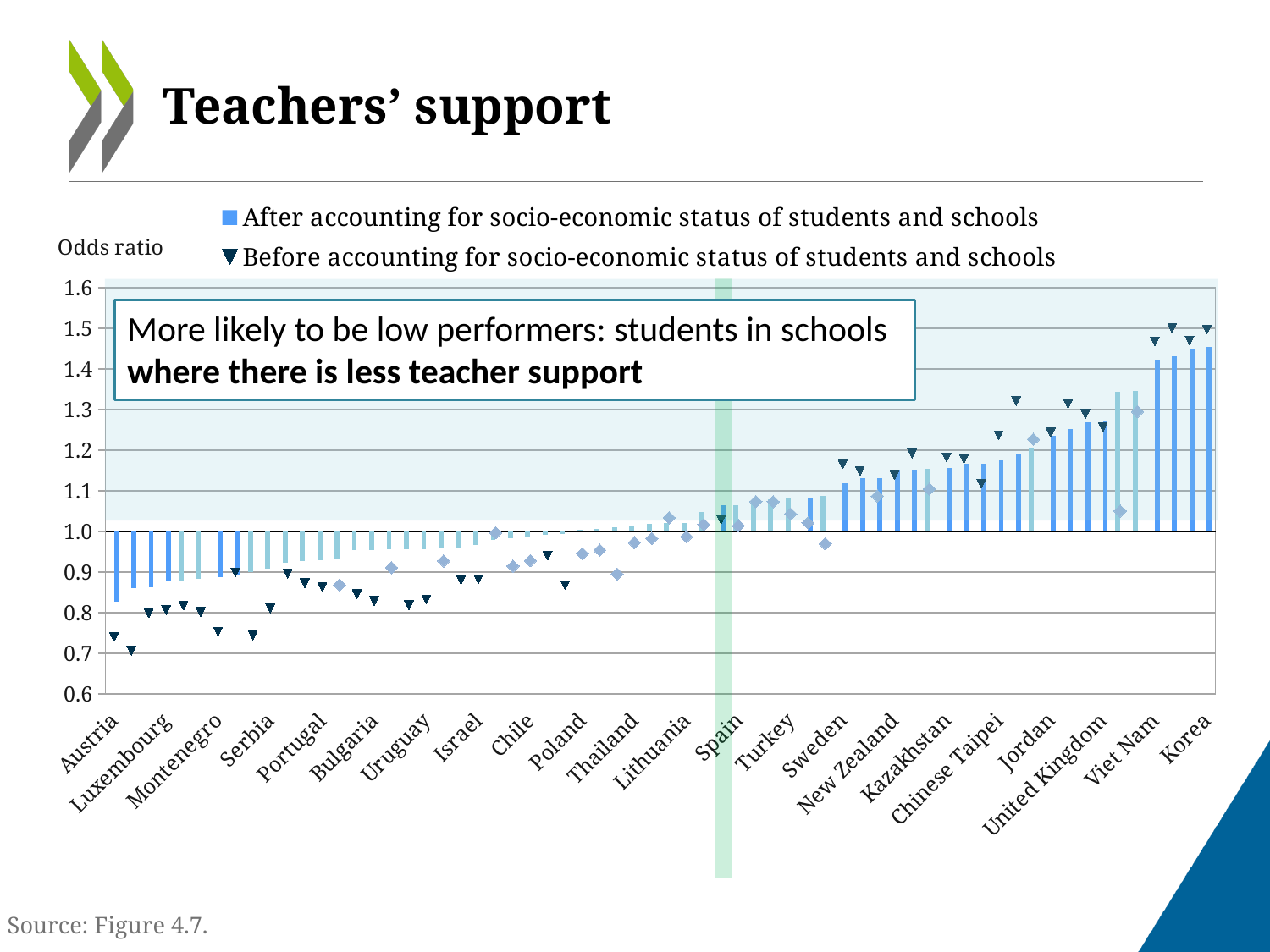
Is the 'Before accounting' value for Austria greater or less than 0.8? less Is the 'After accounting' value for Jordan greater or less than 1.1? greater How many series does the legend list? 2 Which country has the lowest bar for 'After accounting for socio-economic status of students and schools'? Austria Which has the larger 'After accounting' value, Korea or Austria? Korea Which country has the highest bar for 'After accounting for socio-economic status of students and schools'? Korea What kind of chart is shown on the slide? bar chart Which country is highlighted with a shaded vertical band on the chart? Spain Is the 'After accounting' value for Korea greater or less than 1.3? greater Do the 'After accounting' values generally rise or fall from left to right along the x axis? rise